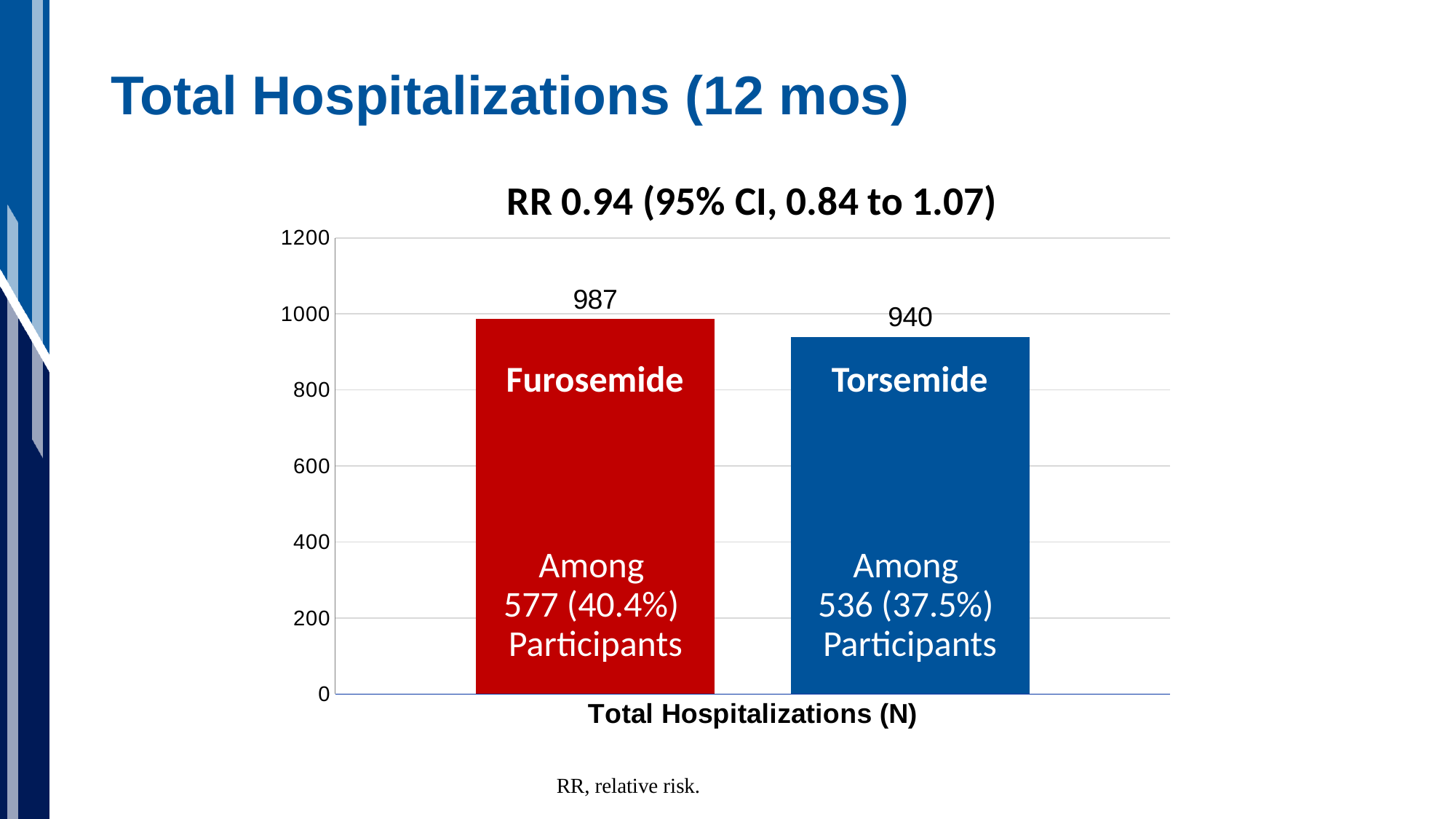
Is the value for Furosemide greater or less than 800? greater What is the chart title shown above the bars? RR 0.94 (95% CI, 0.84 to 1.07) What is the value for Torsemide? 940 What is the difference between the Furosemide and Torsemide values? 47 Which bar is lower, Furosemide or Torsemide? Torsemide What colour is the Torsemide bar? blue Is the value for Torsemide greater or less than 1000? less What is the x-axis label of the chart? Total Hospitalizations (N) What kind of chart is shown on the slide? bar chart Which bar is higher, Furosemide or Torsemide? Furosemide What is the value for Furosemide? 987 How many bars are shown in the chart? 2